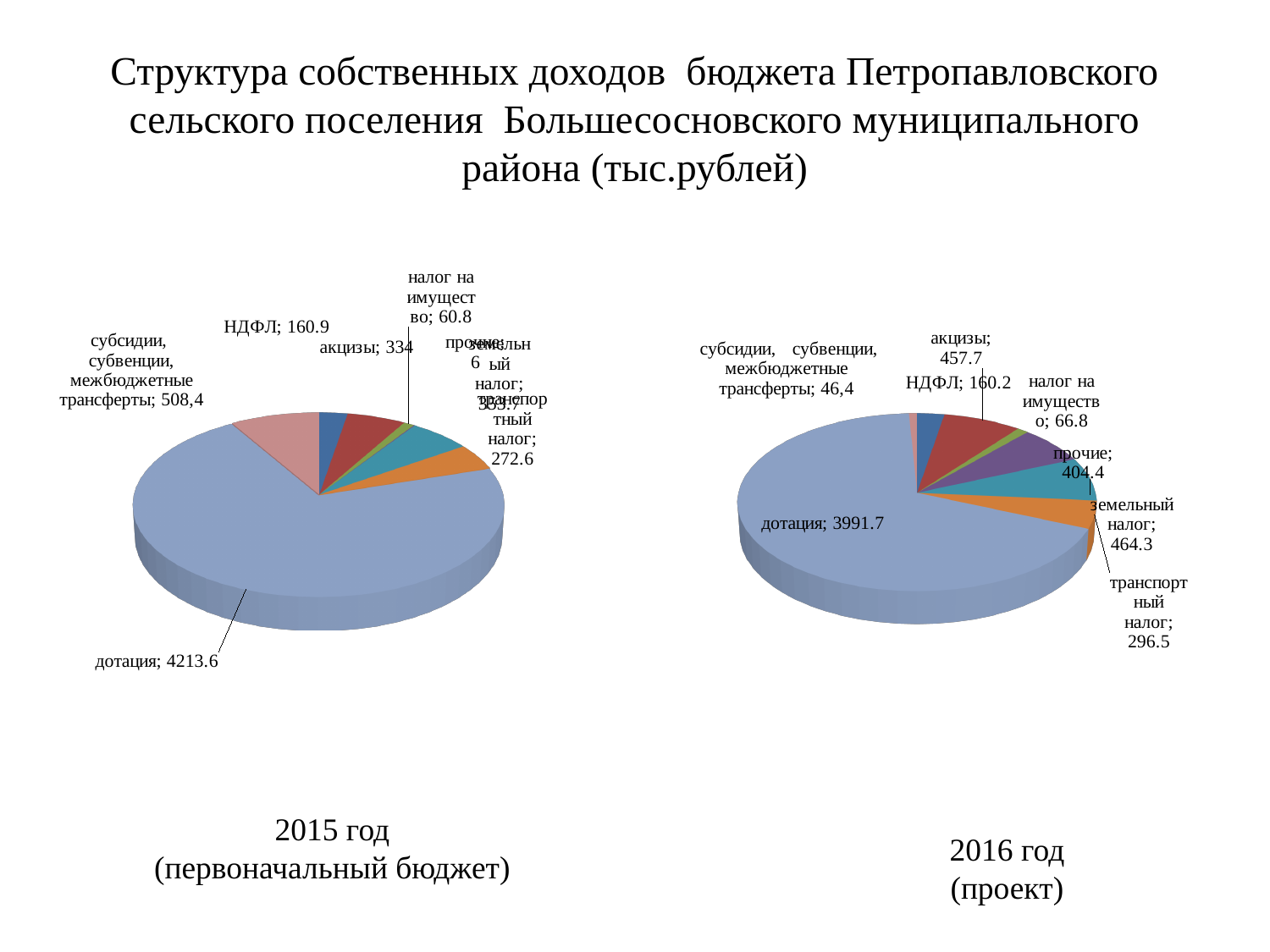
In the 2016 год (проект) chart, what is the value for земельный налог? 464.3 In the 2016 год (проект) chart, what is the difference between земельный налог and акцизы? 6.6 What type of chart is used on the slide for the 2015 год (первоначальный бюджет) data? pie chart In the 2016 год (проект) chart, which category has the smallest value? субсидии, субвенции, межбюджетные трансферты In the 2015 год (первоначальный бюджет) chart, what is the value for транспортный налог? 272.6 In the 2016 год (проект) chart, how many slices does the pie have? 8 In the 2016 год (проект) chart, which is larger: акцизы or налог на имущество? акцизы In the 2015 год (первоначальный бюджет) chart, what is the value for дотация? 4213.6 What is the difference between the дотация value in the 2015 год chart and the дотация value in the 2016 год chart? 221.9 In the 2016 год (проект) chart, what is the value for субсидии, субвенции, межбюджетные трансферты? 46,4 In the 2016 год (проект) chart, which category has the largest slice? дотация In the 2015 год (первоначальный бюджет) chart, what is the value for акцизы? 334